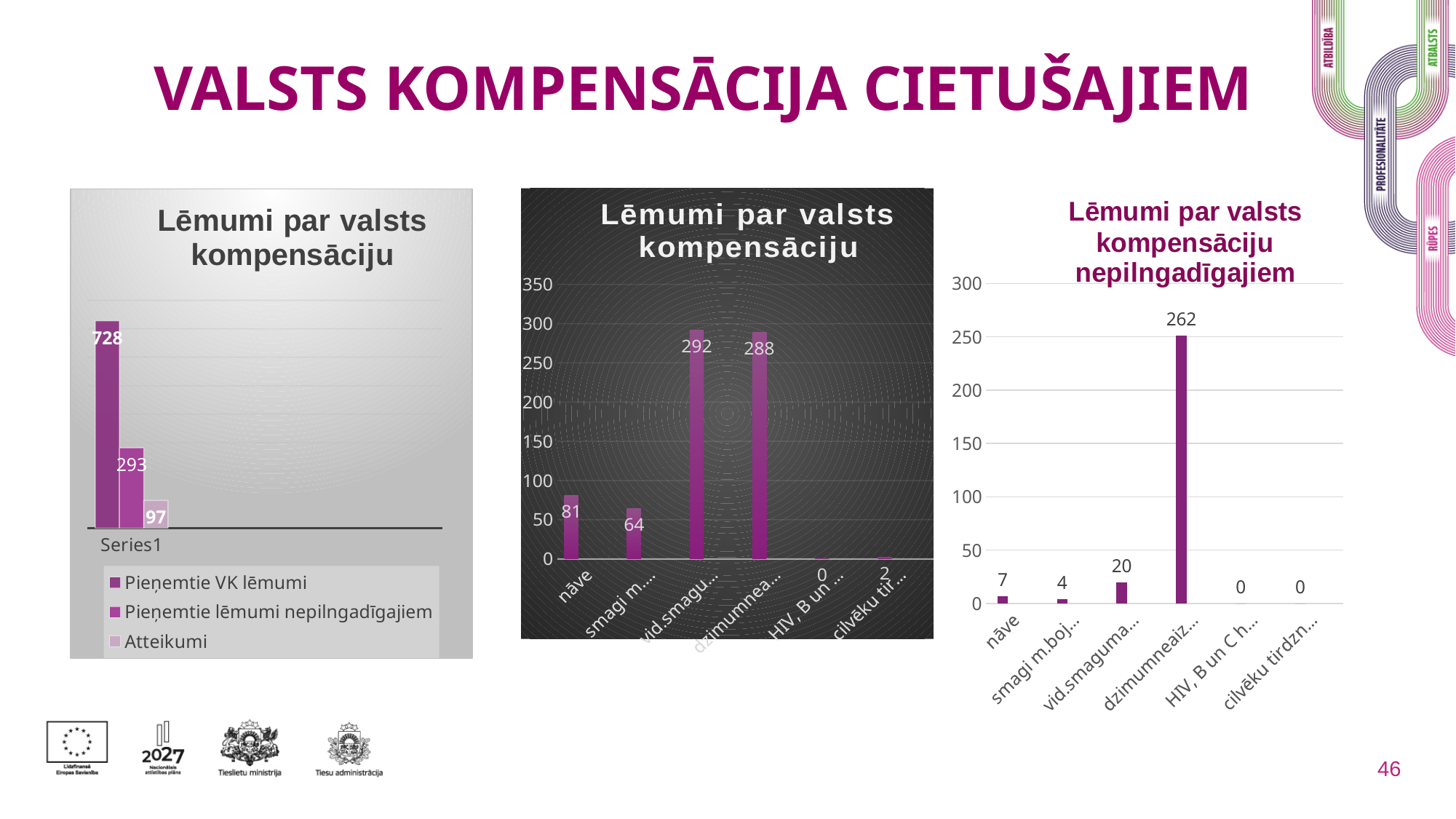
In the left chart, what is the value for Pieņemtie VK lēmumi? 728 In the right chart, what is the value for dzimumneaiz...? 262 What is the title of the right chart? Lēmumi par valsts kompensāciju nepilngadīgajiem In the middle chart, which category has the highest value? vid.smagu... In the right chart, what is the value for vid.smaguma...? 20 In the left chart, what is the value for Atteikumi? 97 In the middle chart, what is the value for nāve? 81 In the left chart, what is the difference between Pieņemtie VK lēmumi and Pieņemtie lēmumi nepilngadīgajiem? 435 How many series does the legend of the left chart list? 3 What kind of chart is the middle chart? bar chart In the right chart, which is larger, the value for nāve or the value for smagi m.boj...? nāve In the middle chart, how many categories are shown on the x axis? 6